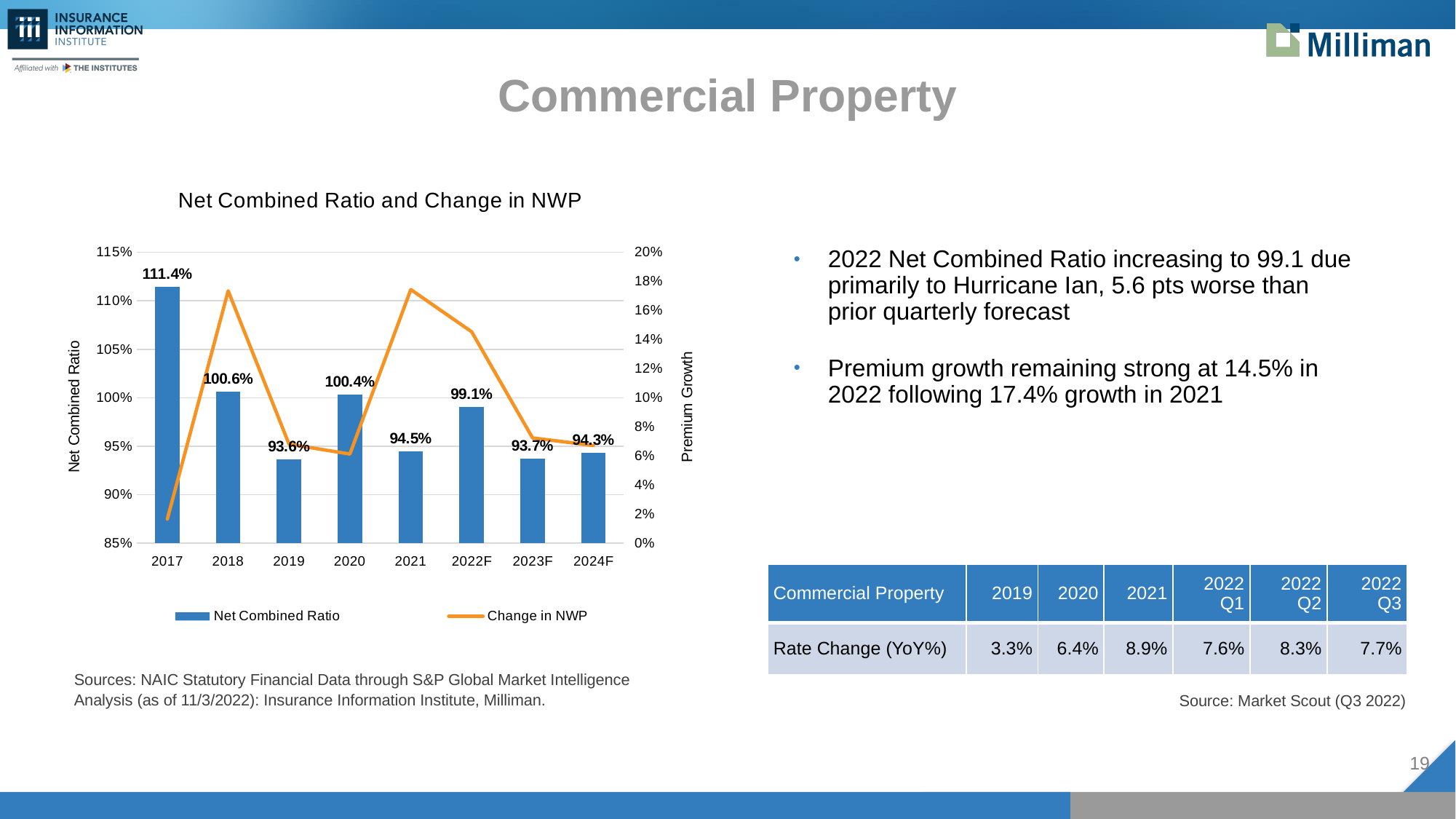
How many series does the chart legend list? 2 Which year has the highest Net Combined Ratio? 2017 Does the Net Combined Ratio rise or fall from 2017 to 2019? Fall What is the difference between the Net Combined Ratio in 2017 and in 2018? 10.8 percentage points Is the Change in NWP for 2021 greater or less than 16%? greater What is the Net Combined Ratio for 2024F? 94.3% What kind of chart is used to show the Net Combined Ratio? Bar chart Is the Change in NWP for 2017 greater or less than 4%? less Which is larger, the Net Combined Ratio for 2018 or for 2020? 2018 What is the Net Combined Ratio for 2017? 111.4% What is the Net Combined Ratio for 2022F? 99.1% How many years are shown on the x axis of the chart? 8